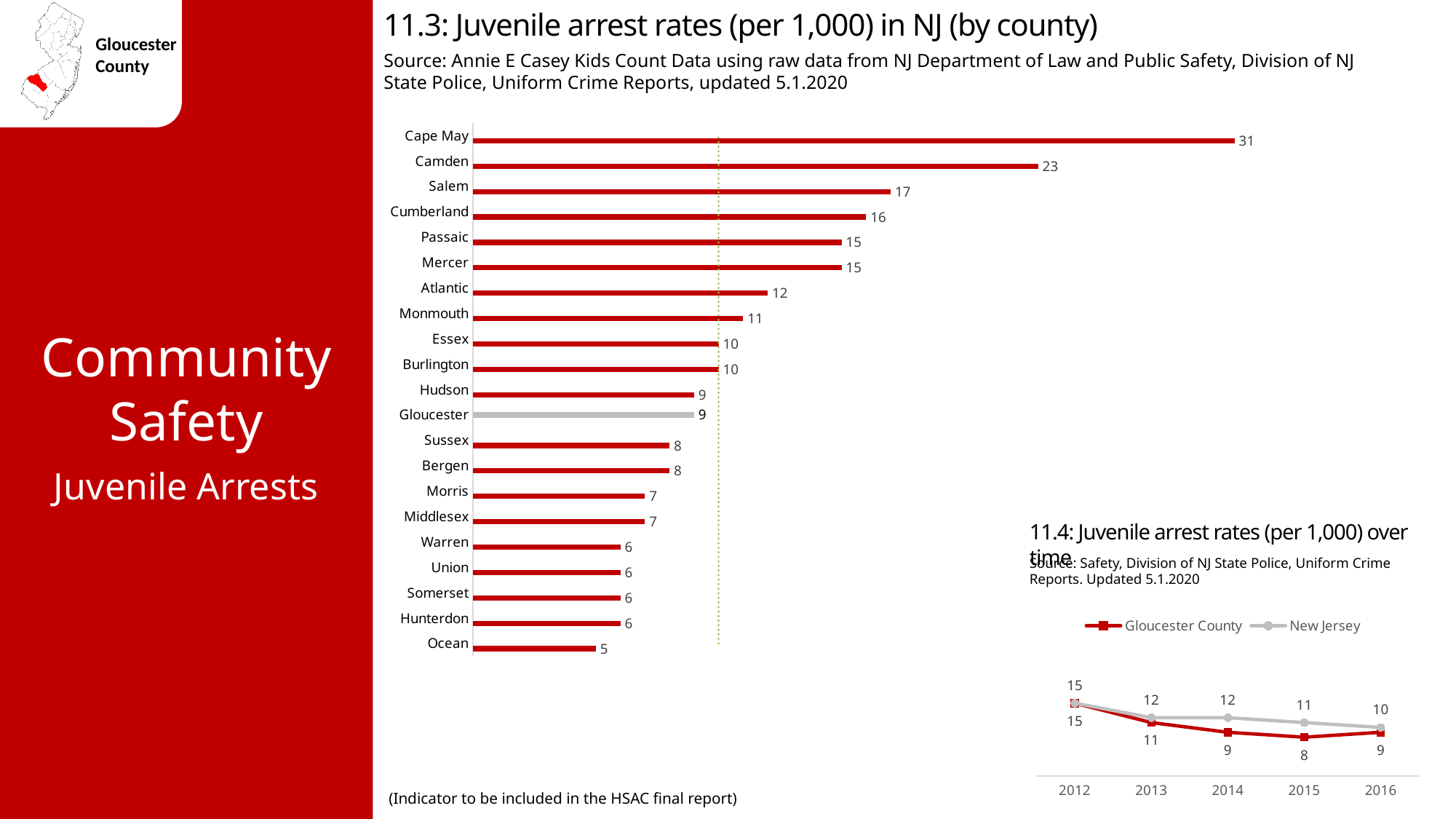
In chart 11.3 (juvenile arrest rates by county), which county has the lowest juvenile arrest rate? Ocean In chart 11.4 (juvenile arrest rates over time), how many series does the legend list? 2 What kind of chart is chart 11.3 (juvenile arrest rates by county)? Bar chart In chart 11.4 (juvenile arrest rates over time), does the New Jersey rate rise or fall from 2012 to 2016? Fall In chart 11.4 (juvenile arrest rates over time), what was the New Jersey rate in 2016? 10 In chart 11.3 (juvenile arrest rates by county), what is the juvenile arrest rate for Cape May? 31 In chart 11.3 (juvenile arrest rates by county), which county has a higher rate, Atlantic or Monmouth? Atlantic In chart 11.4 (juvenile arrest rates over time), what was the Gloucester County rate in 2015? 8 In chart 11.3 (juvenile arrest rates by county), what is the juvenile arrest rate for Gloucester? 9 In chart 11.3 (juvenile arrest rates by county), how many counties are shown? 21 In chart 11.3 (juvenile arrest rates by county), which county has the highest juvenile arrest rate? Cape May In chart 11.3 (juvenile arrest rates by county), what is the difference between the rates for Camden and Salem? 6